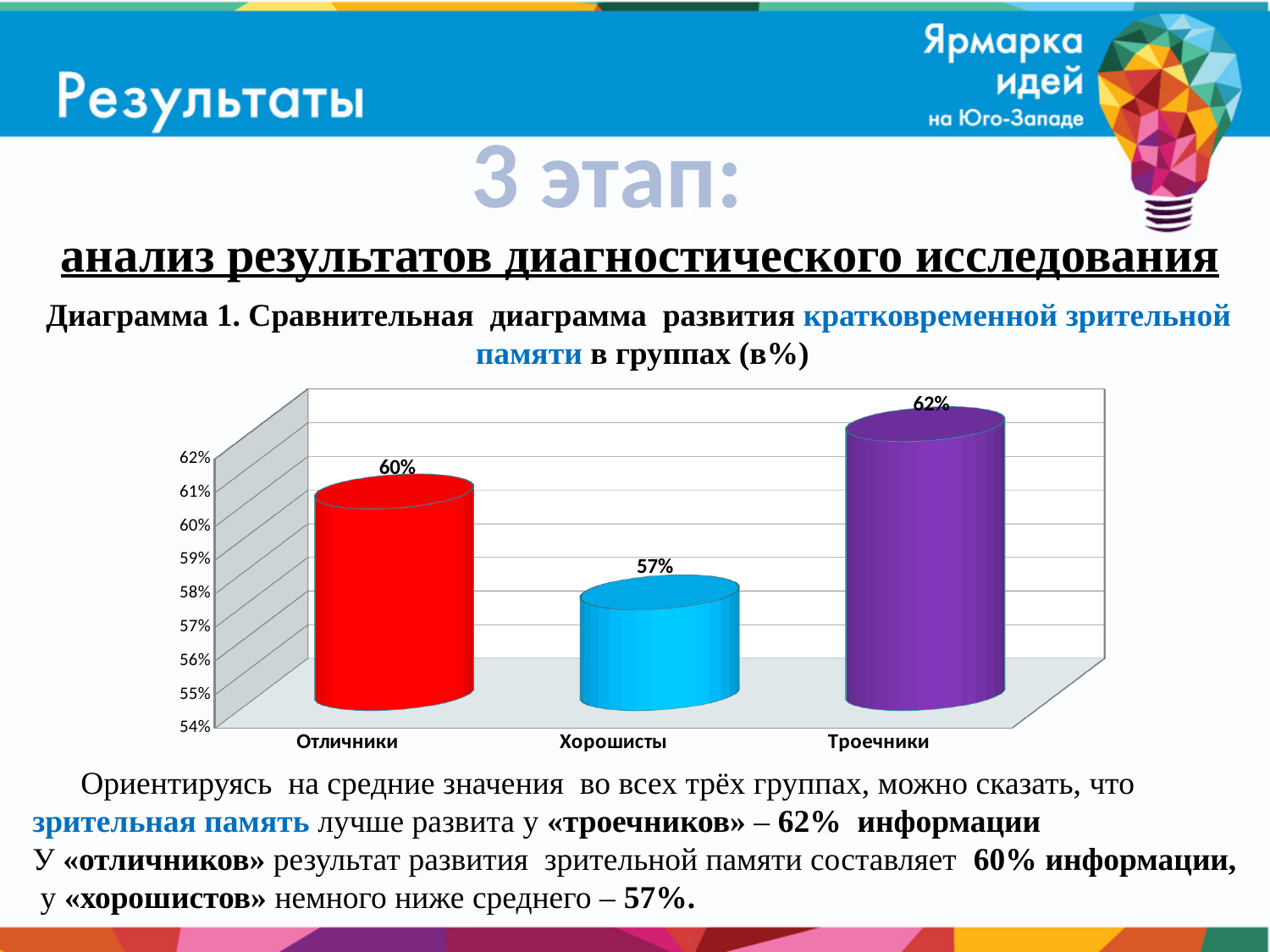
What is the difference between the values for Троечники and Хорошисты? 5% What is the difference between the values for Отличники and Хорошисты? 3% How many groups are shown on the chart? 3 Is the value for Хорошисты greater or less than 60%? less Which is larger, the value for Отличники or the value for Троечники? Троечники What is the value for Отличники? 60% Which group has the highest value? Троечники What colour is the bar for Троечники? purple What is the value for Хорошисты? 57% What kind of chart is shown on the slide? bar chart Which group has the lowest value? Хорошисты What is the value for Троечники? 62%